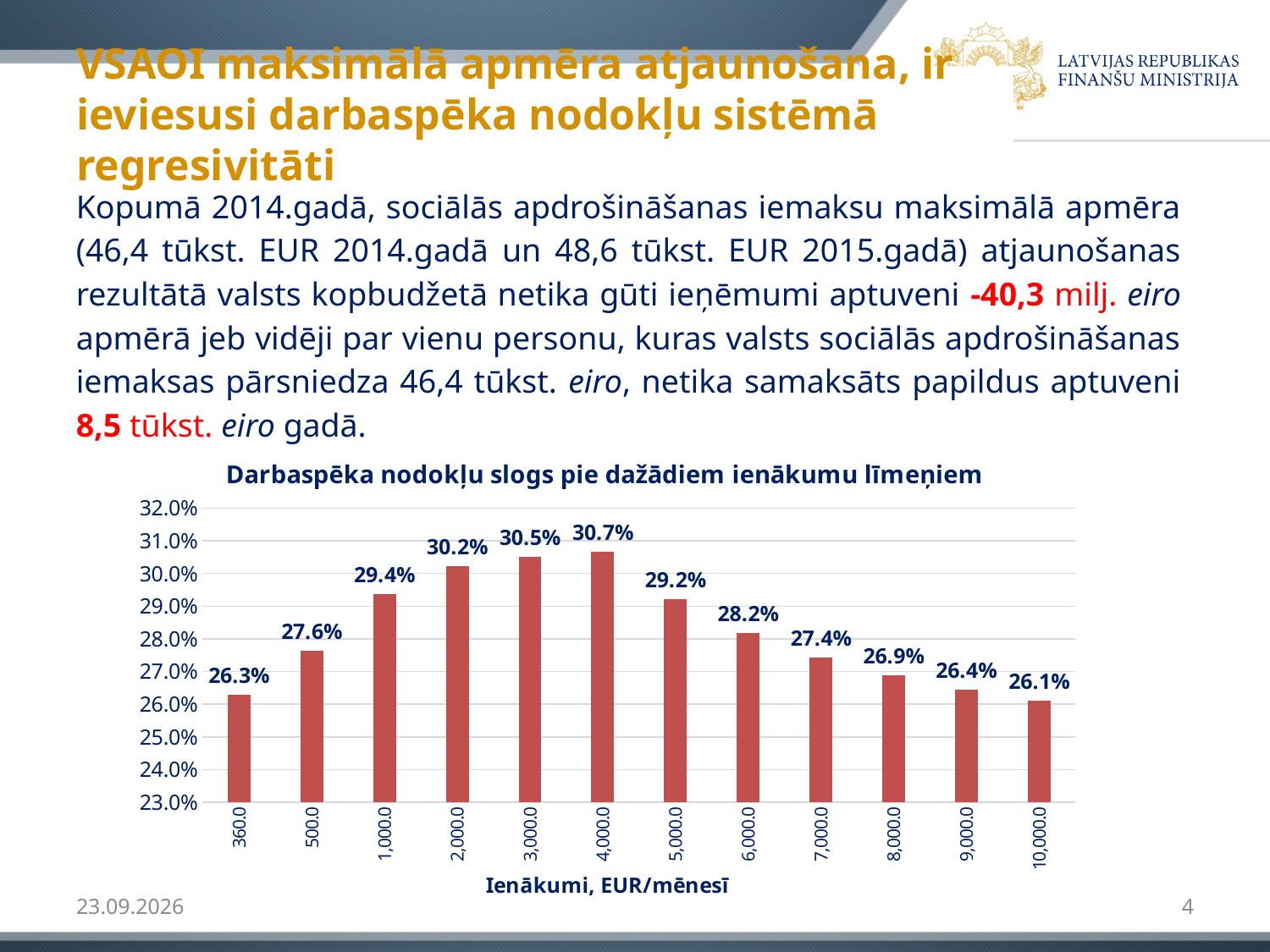
How do the values change from 4,000.0 to 10,000.0 along the x axis? They fall What kind of chart is shown on the slide? bar chart Is the value for 6,000.0 greater or less than 29.0%? less Which has a higher value, 500.0 or 9,000.0? 500.0 What is the difference between the values for 4,000.0 and 10,000.0? 4.6 percentage points How many income levels are shown on the x axis? 12 What is the value for the 4,000.0 income level? 30.7% What is the title of the chart? Darbaspēka nodokļu slogs pie dažādiem ienākumu līmeņiem What is the value for the 360.0 income level? 26.3% Which income level has the highest tax burden? 4,000.0 What is the value for the 7,000.0 income level? 27.4% Which income level has the lowest tax burden? 10,000.0